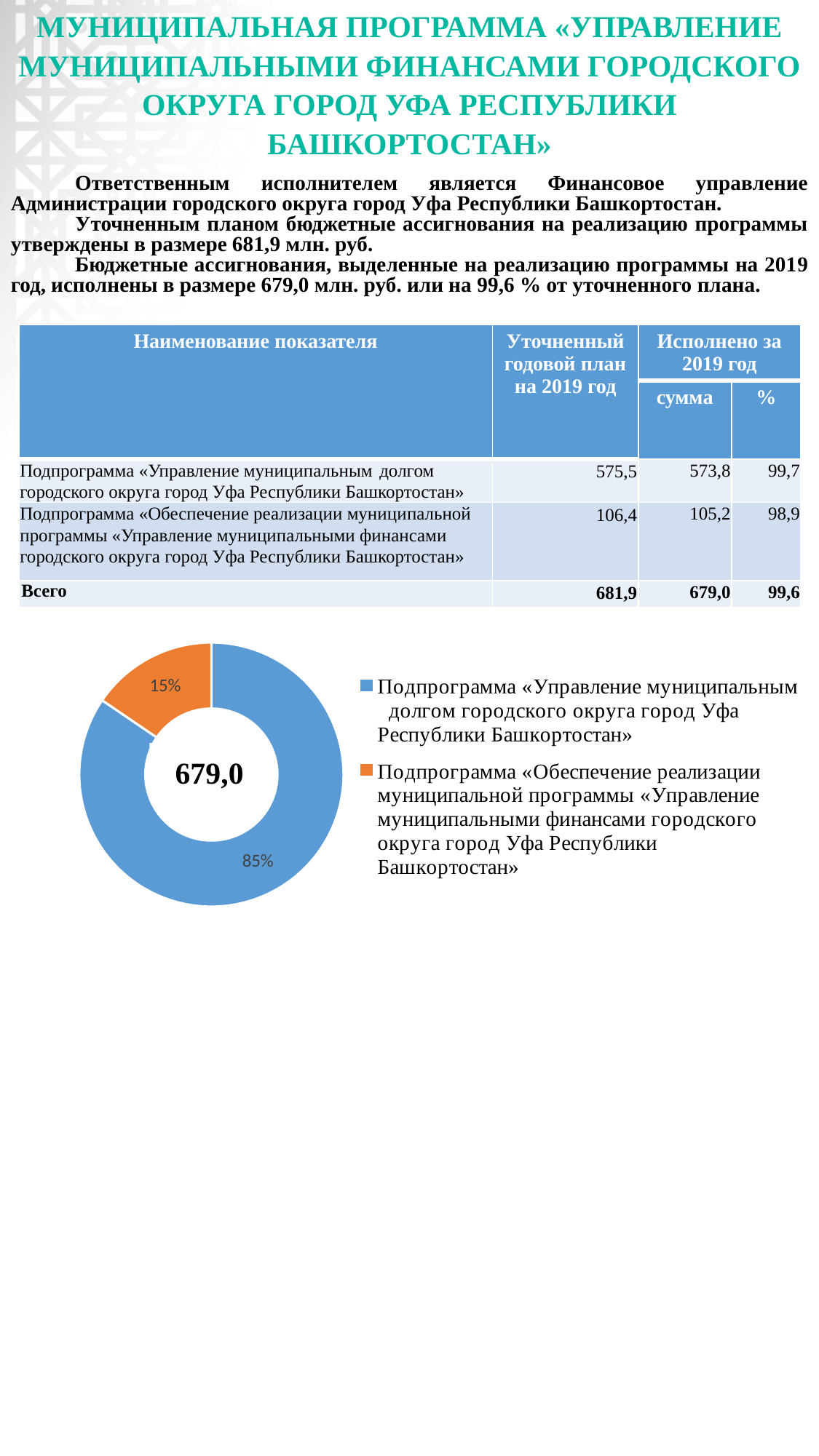
Which slice of the doughnut chart is the largest? Подпрограмма «Управление муниципальным долгом городского округа город Уфа Республики Башкортостан» What is the difference in percentage points between the two slices of the doughnut chart? 70 percentage points Which slice is larger in the doughnut chart: the blue one or the orange one? The blue one How many slices does the doughnut chart have? 2 What share of the doughnut chart does the subprogram «Управление муниципальным долгом городского округа город Уфа Республики Башкортостан» take? 85% Is the share of the blue slice in the doughnut chart greater or less than 50%? greater Which slice of the doughnut chart is the smallest? Подпрограмма «Обеспечение реализации муниципальной программы «Управление муниципальными финансами городского округа город Уфа Республики Башкортостан»» What kind of chart is shown on the slide? Doughnut (pie) chart What share of the doughnut chart does the subprogram «Обеспечение реализации муниципальной программы «Управление муниципальными финансами городского округа город Уфа Республики Башкортостан»» take? 15% How many entries does the legend of the doughnut chart list? 2 What value is printed in the centre of the doughnut chart? 679,0 What colour is the slice for the subprogram «Обеспечение реализации муниципальной программы...» in the doughnut chart? Orange